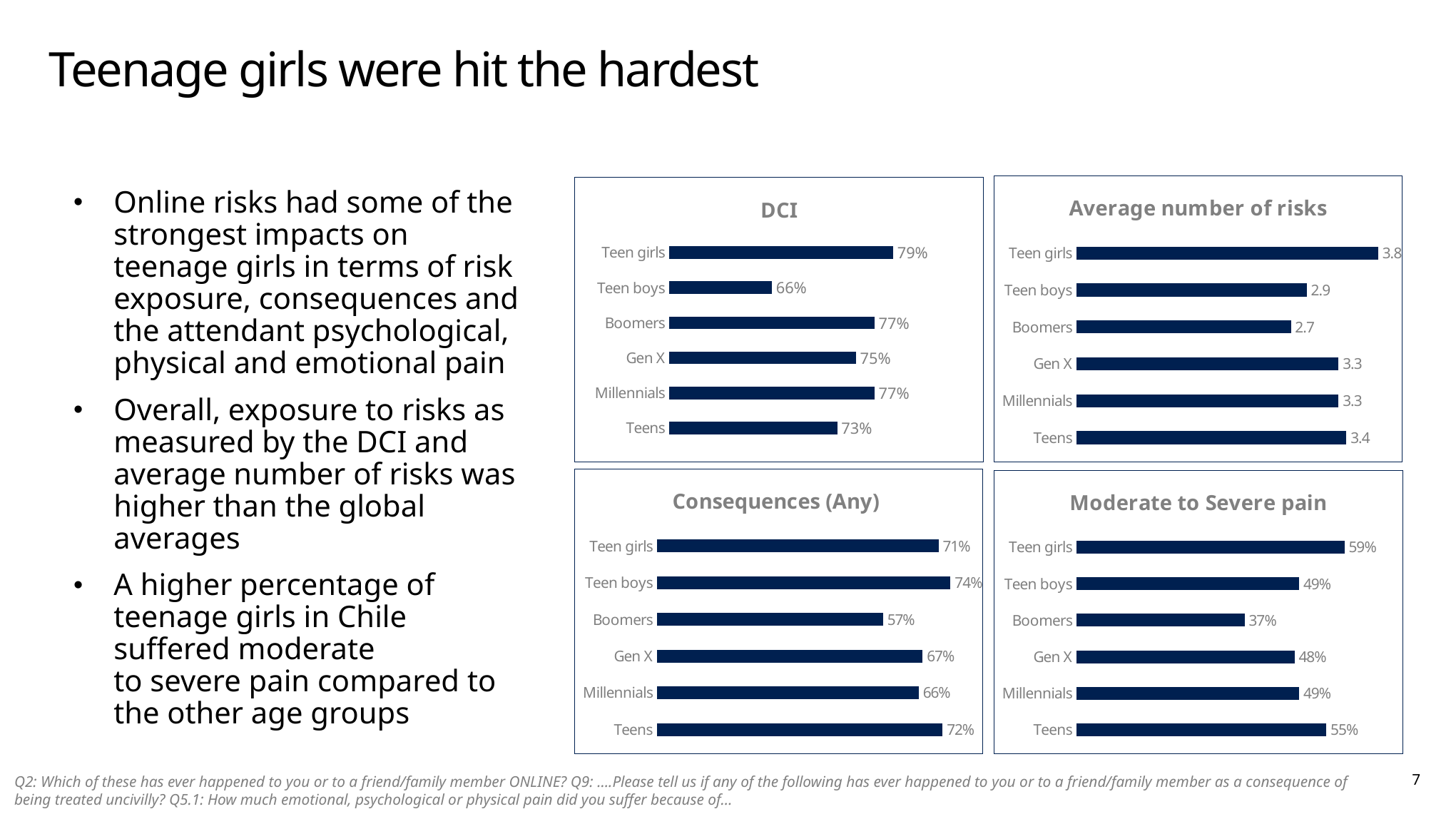
In the DCI chart, which category has the lowest value? Teen boys In the Moderate to Severe pain chart, which is larger, the value for Teens or the value for Gen X? Teens In the Consequences (Any) chart, which category has the lowest value? Boomers In the Consequences (Any) chart, what is the value for Teen boys? 74% In the DCI chart, what is the difference between Teen girls and Teen boys? 13% How many charts are shown on the slide? 4 In the Average number of risks chart, which category has the highest value? Teen girls What kind of chart is the Average number of risks chart? Bar chart In the Average number of risks chart, what is the value for Boomers? 2.7 In the Moderate to Severe pain chart, what is the difference between Teen girls and Boomers? 22% How many categories are shown in the Consequences (Any) chart? 6 In the DCI chart, what is the value for Teen girls? 79%